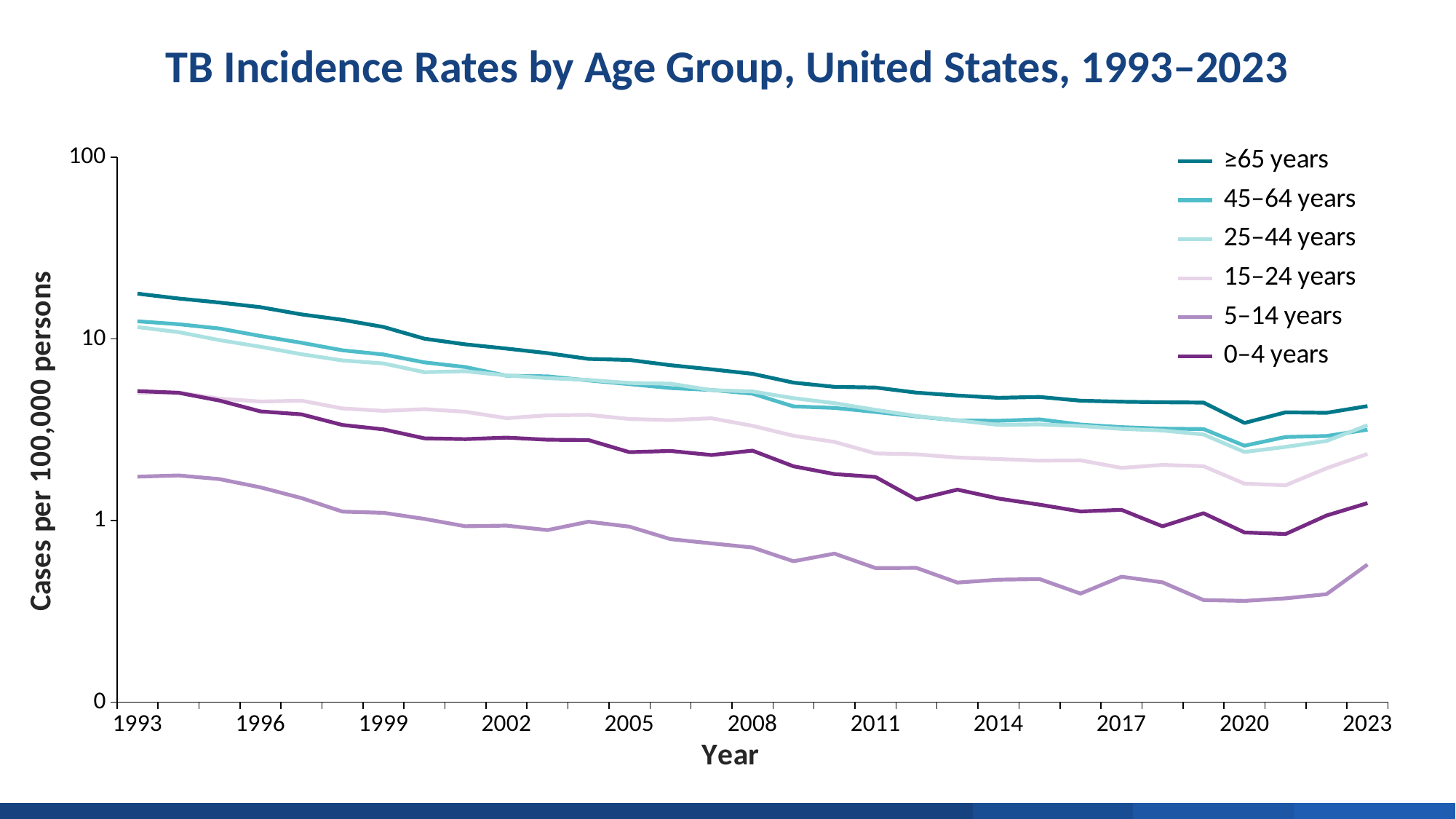
Which age group has the highest TB incidence rate in 1993? ≥65 years Is the value for the 5–14 years group in 2020 greater or less than 1? less What is the label on the y axis? Cases per 100,000 persons How many age groups does the legend list? 6 Is the value for the 0–4 years group in 2008 greater or less than 1? greater What kind of chart is shown on the slide? line chart Which age group has the lowest TB incidence rate in 2023? 5–14 years Which age group has the lowest TB incidence rate in 1993? 5–14 years What is the title of the chart? TB Incidence Rates by Age Group, United States, 1993–2023 In 2023, which is larger: the rate for the ≥65 years group or the rate for the 5–14 years group? ≥65 years Is the value for the ≥65 years group in 1993 greater or less than 10? greater Does the TB incidence rate for the ≥65 years group rise or fall from 1993 to 2023? fall